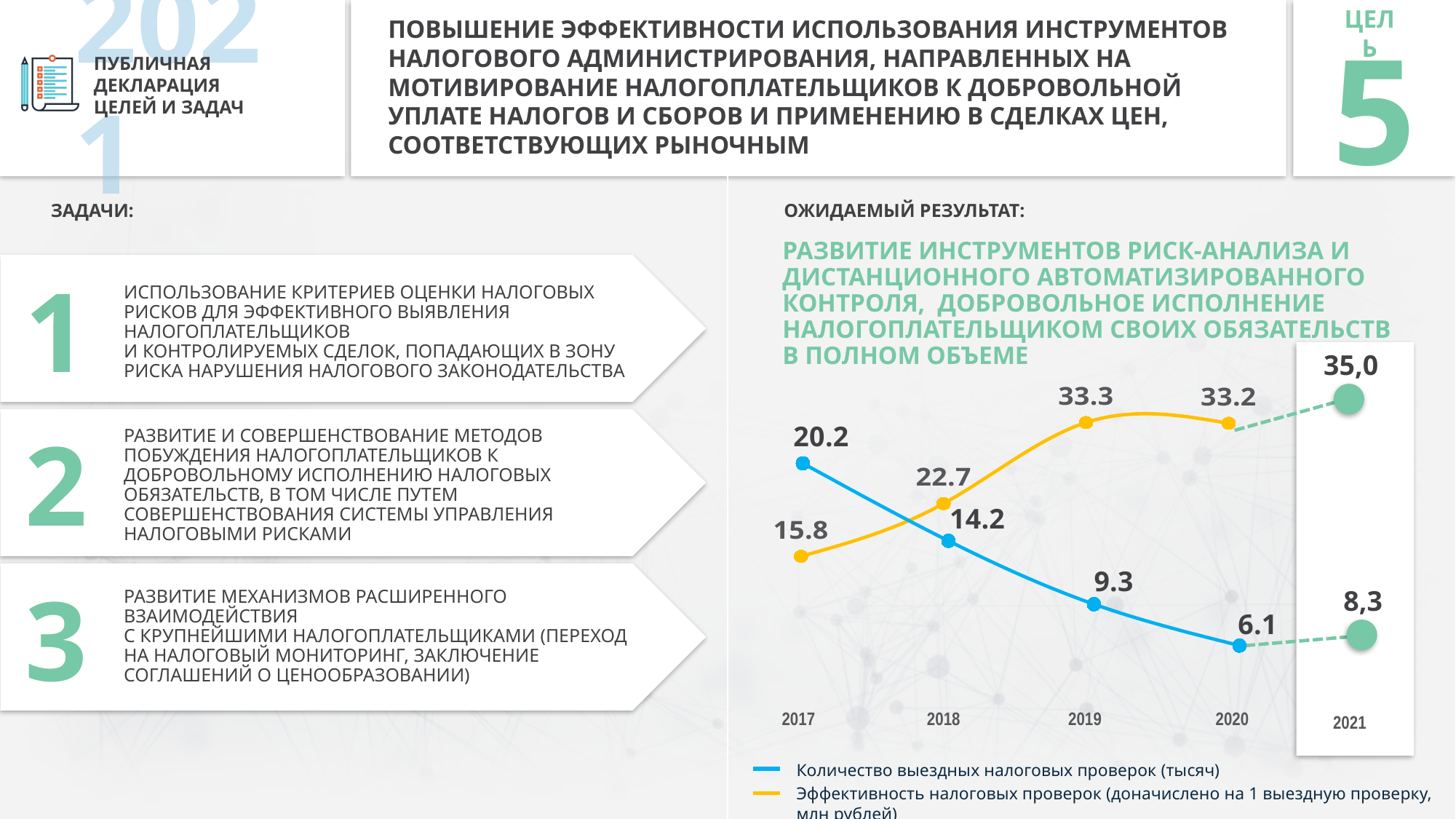
In which year is 'Эффективность налоговых проверок' highest? 2021 How many series does the chart legend list? 2 In which year is 'Количество выездных налоговых проверок (тысяч)' lowest? 2020 What is the value of 'Эффективность налоговых проверок' in 2019? 33.3 What is the difference between the 2017 and 2018 values of 'Количество выездных налоговых проверок (тысяч)'? 6.0 What is the value of 'Количество выездных налоговых проверок (тысяч)' in 2017? 20.2 Does 'Количество выездных налоговых проверок (тысяч)' rise or fall from 2017 to 2020? fall What is the projected value of 'Эффективность налоговых проверок' for 2021? 35,0 What type of chart is shown on the slide? line chart Which is larger in 2018: 'Количество выездных налоговых проверок' or 'Эффективность налоговых проверок'? Эффективность налоговых проверок How many years are shown on the x axis of the chart? 5 What is the value of 'Количество выездных налоговых проверок (тысяч)' in 2020? 6.1